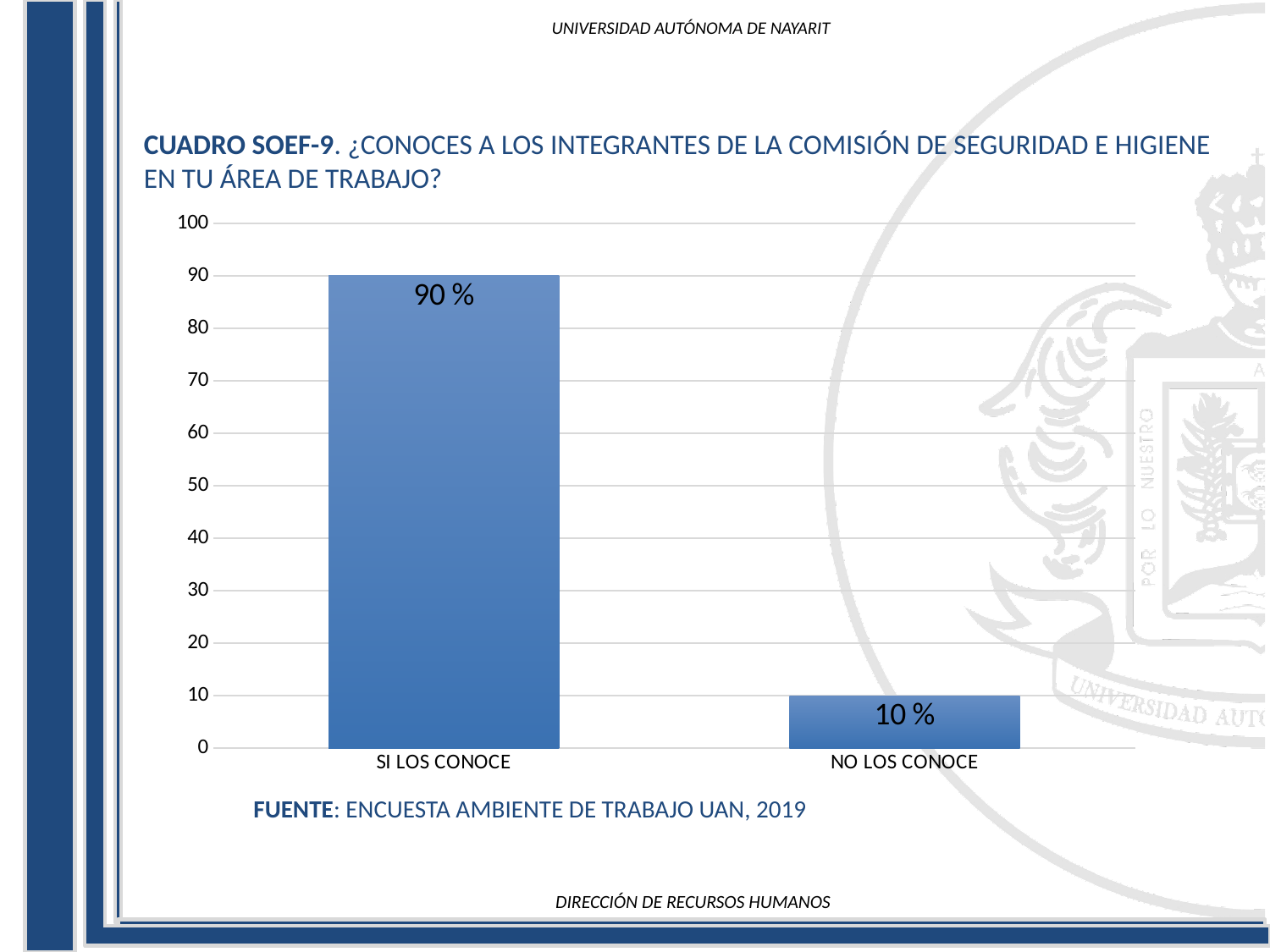
Is the value for SI LOS CONOCE greater or less than 50? greater Which category has the highest value? SI LOS CONOCE What is the maximum value shown on the vertical axis? 100 What is the source cited below the chart? ENCUESTA AMBIENTE DE TRABAJO UAN, 2019 What is the value for NO LOS CONOCE? 10 % What is the difference between the values for SI LOS CONOCE and NO LOS CONOCE? 80 % Which category has the lowest value? NO LOS CONOCE What is the value for SI LOS CONOCE? 90 % Is the value for NO LOS CONOCE greater or less than 20? less Which is larger, the value for SI LOS CONOCE or the value for NO LOS CONOCE? SI LOS CONOCE What kind of chart is shown on the slide? Bar chart How many categories are shown on the chart? 2